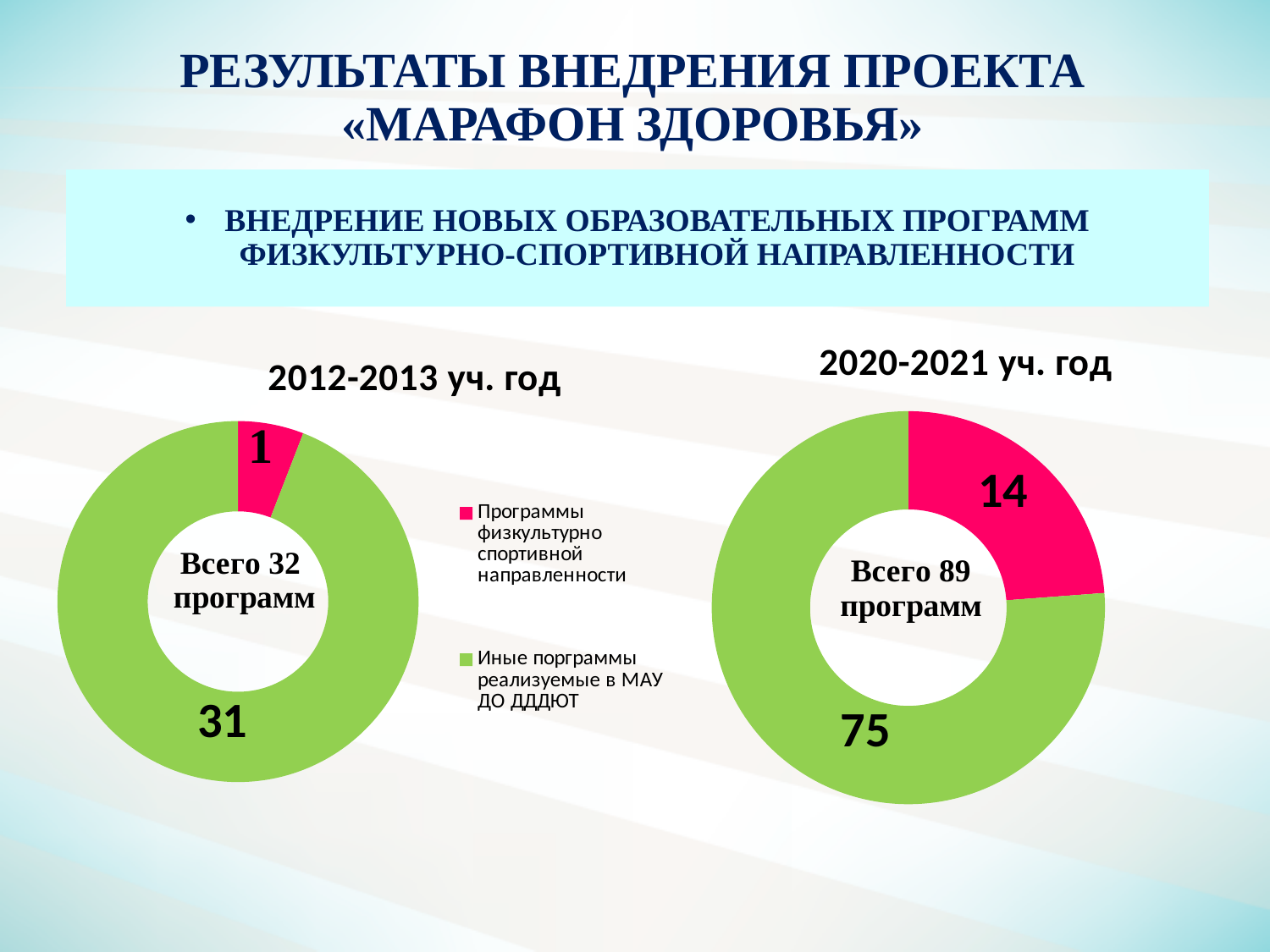
In the "2020-2021 уч. год" chart, what is the value for "Иные порграммы реализуемые в МАУ ДО ДДДЮТ"? 75 In the "2012-2013 уч. год" chart, what is the value for "Программы физкультурно спортивной направленности"? 1 How many categories does the legend list? 2 In the "2012-2013 уч. год" chart, what is the value for "Иные порграммы реализуемые в МАУ ДО ДДДЮТ"? 31 What is the total number of programs shown in the "2020-2021 уч. год" chart? 89 In the "2012-2013 уч. год" chart, which category has the smallest value? Программы физкультурно спортивной направленности In the "2020-2021 уч. год" chart, which category has the largest value? Иные порграммы реализуемые в МАУ ДО ДДДЮТ In the "2020-2021 уч. год" chart, what is the difference between the two categories' values? 61 Which is larger: the value for "Программы физкультурно спортивной направленности" in the "2012-2013 уч. год" chart or in the "2020-2021 уч. год" chart? 2020-2021 уч. год In the "2020-2021 уч. год" chart, what is the value for "Программы физкультурно спортивной направленности"? 14 What is the total number of programs shown in the "2012-2013 уч. год" chart? 32 What type of chart is used for "2020-2021 уч. год"? Doughnut chart